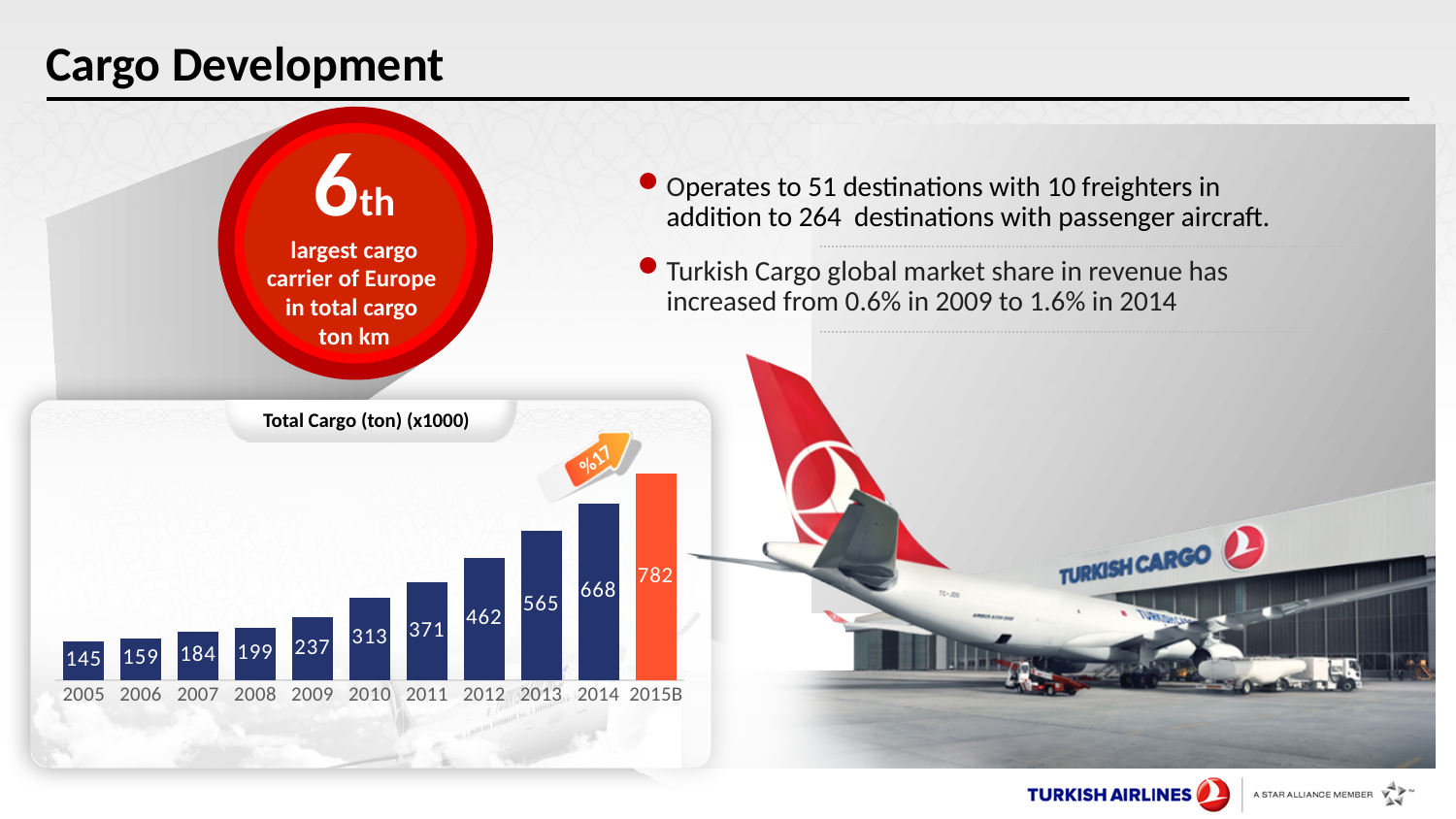
Which year has the lowest value in the Total Cargo (ton) (x1000) chart? 2005 What is the difference between the 2014 and 2013 values in the Total Cargo (ton) (x1000) chart? 103 Which is larger in the Total Cargo (ton) (x1000) chart, the value for 2011 or the value for 2012? 2012 How many years are shown in the Total Cargo (ton) (x1000) chart? 11 Do the values in the Total Cargo (ton) (x1000) chart rise or fall from 2005 to 2015B? Rise What is the value for 2005 in the Total Cargo (ton) (x1000) chart? 145 What kind of chart is the Total Cargo (ton) (x1000) chart? Bar chart What is the value for 2010 in the Total Cargo (ton) (x1000) chart? 313 Which year has the highest value in the Total Cargo (ton) (x1000) chart? 2015B What is the title of the bar chart on the slide? Total Cargo (ton) (x1000) What is the value for 2015B in the Total Cargo (ton) (x1000) chart? 782 What is the difference between the 2015B and 2005 values in the Total Cargo (ton) (x1000) chart? 637